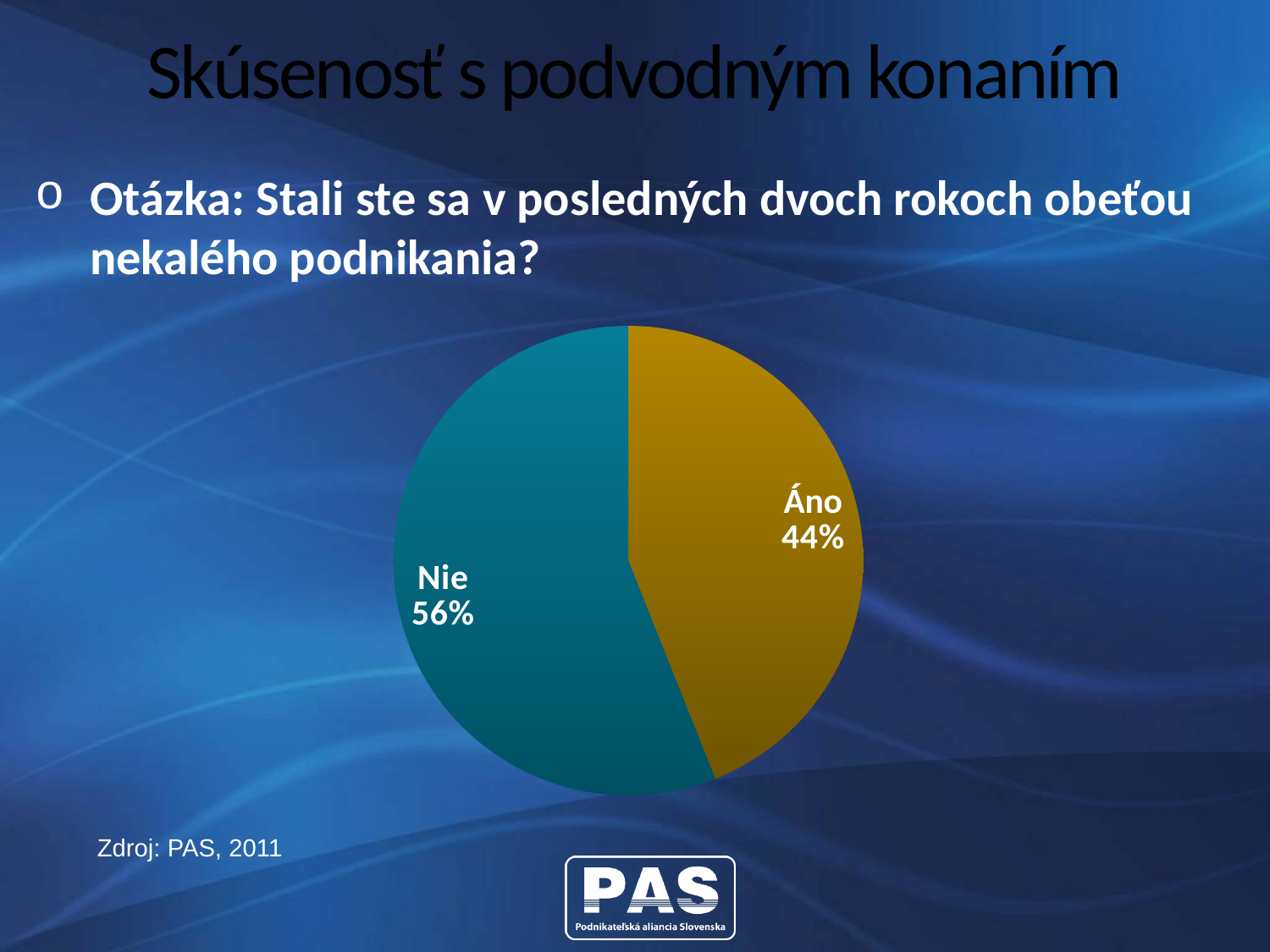
How many slices does the pie chart have? 2 Which slice of the pie is the smallest? Áno What share of the pie does the "Áno" slice represent? 44% What colour is the "Nie" slice of the pie? teal Is the value for "Nie" greater or less than 50%? greater What source is cited below the chart? PAS, 2011 Which slice of the pie is the largest? Nie What is the difference in percentage points between the "Nie" and "Áno" slices? 12 Which is larger, the "Áno" slice or the "Nie" slice? Nie What share of the pie does the "Nie" slice represent? 56% What kind of chart is shown on the slide? pie chart Is the value for "Áno" greater or less than 50%? less